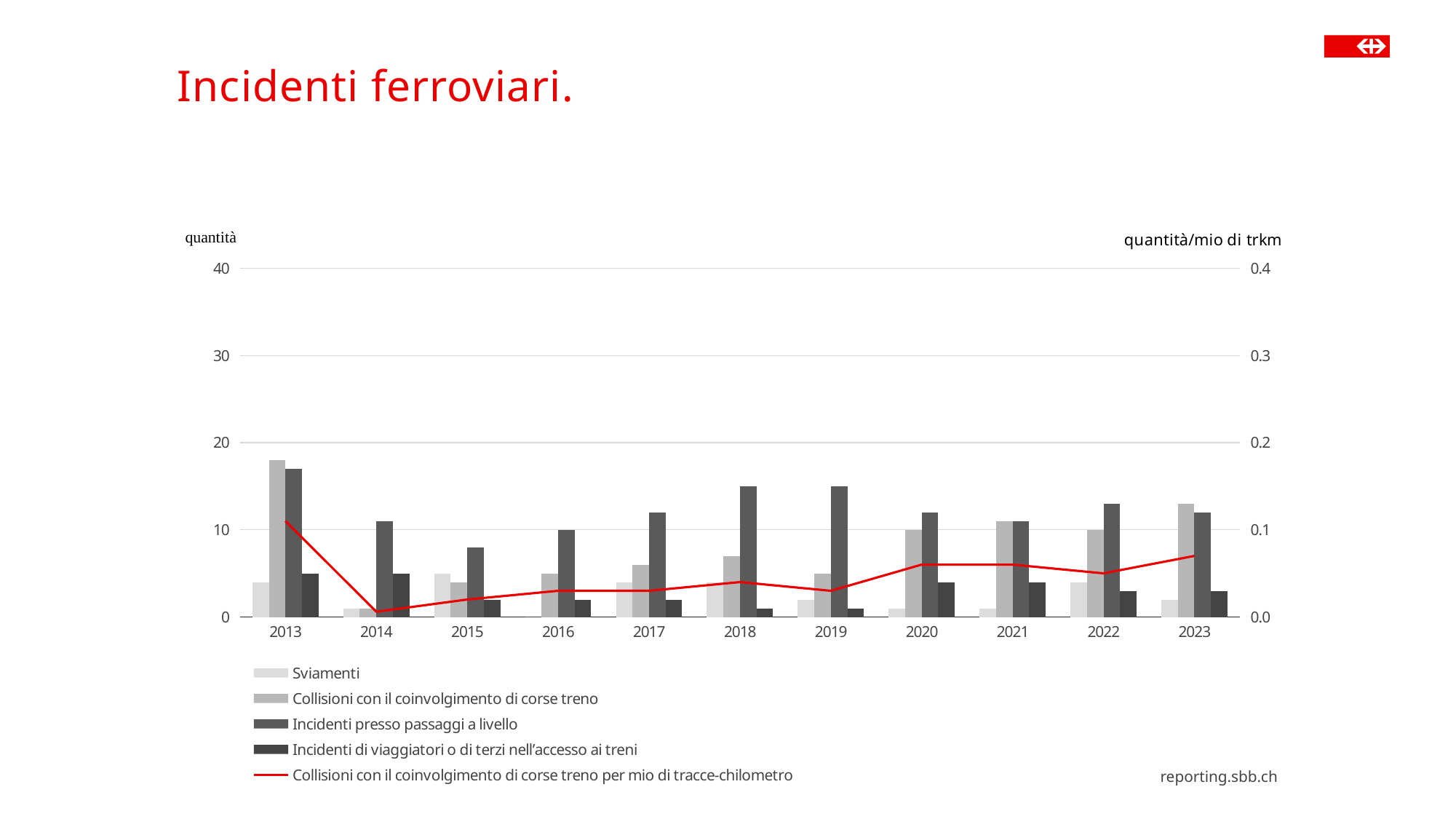
In which year is the red line (Collisioni con il coinvolgimento di corse treno per mio di tracce-chilometro) at its lowest? 2014 Which year has the larger value for Collisioni con il coinvolgimento di corse treno, 2013 or 2023? 2013 Is the value for Collisioni con il coinvolgimento di corse treno in 2013 greater or less than 10? greater Is the value of the red line (Collisioni per mio di tracce-chilometro) in 2014 greater or less than 0.1? less What is the title of the chart? Incidenti ferroviari. What is the value for Incidenti presso passaggi a livello in 2016? 10 What is the value for Collisioni con il coinvolgimento di corse treno in 2020? 10 How many series does the legend list? 5 In which year is the red line (Collisioni con il coinvolgimento di corse treno per mio di tracce-chilometro) at its highest? 2013 What kind of chart is this? Combined bar and line chart How many years are shown on the x axis? 11 Is the value for Sviamenti in 2014 greater or less than 10? less